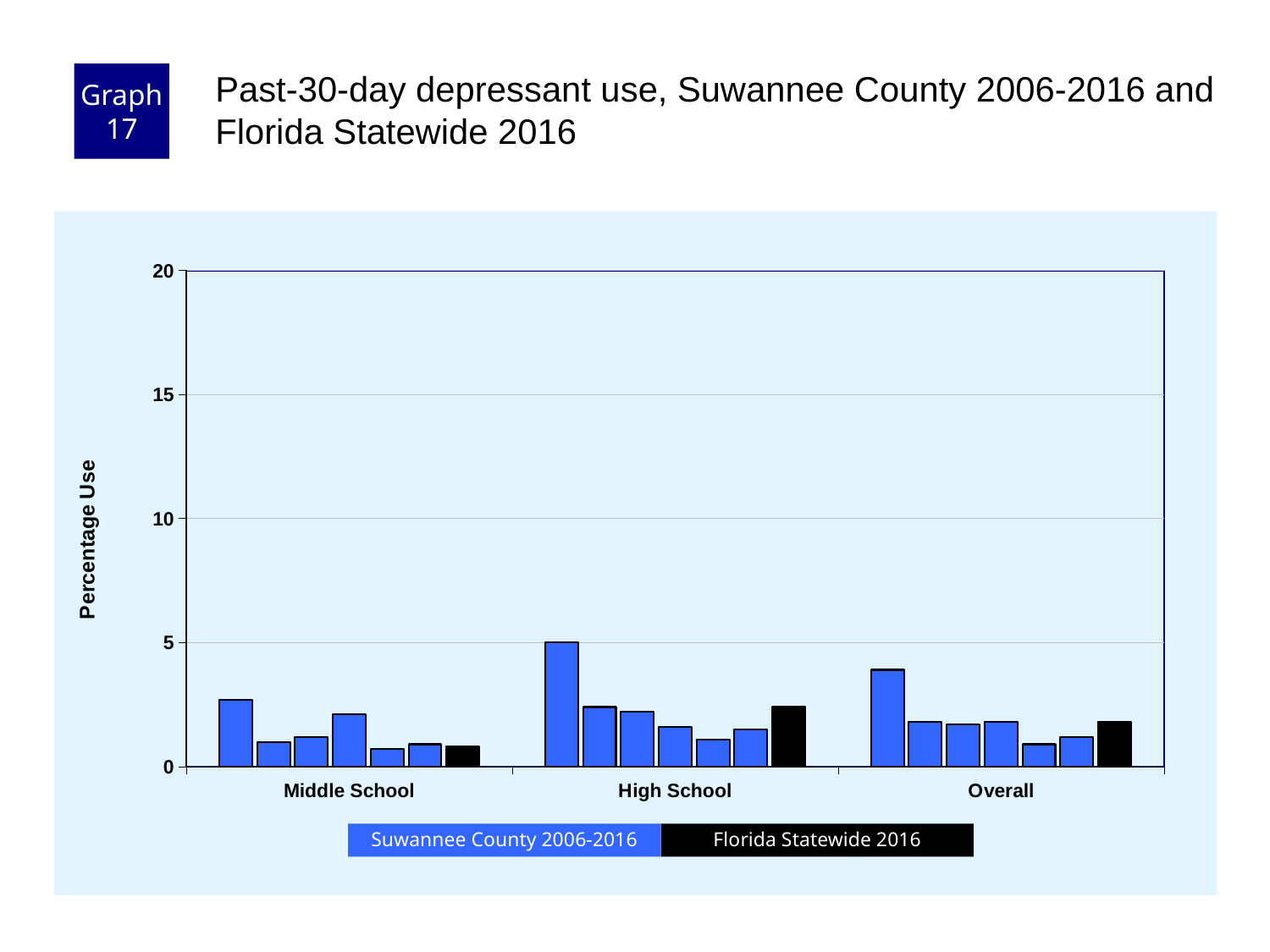
Is the tallest Suwannee County bar in the Overall group greater or less than 5? less Is the Florida Statewide 2016 value for High School greater or less than 5? less What colour are the Florida Statewide 2016 bars? black Which category group contains the tallest bar on the chart? High School In which category group is the Florida Statewide 2016 bar the lowest? Middle School Do the Suwannee County 2006-2016 bars in the High School group generally rise or fall from left to right? fall What is the title of the y axis? Percentage Use What kind of chart is shown on the slide? bar chart How many series does the legend list? 2 Which is larger, the Florida Statewide 2016 value for High School or for Middle School? High School Is the tallest bar in the Middle School group greater or less than 5? less How many category groups are shown on the x axis? 3